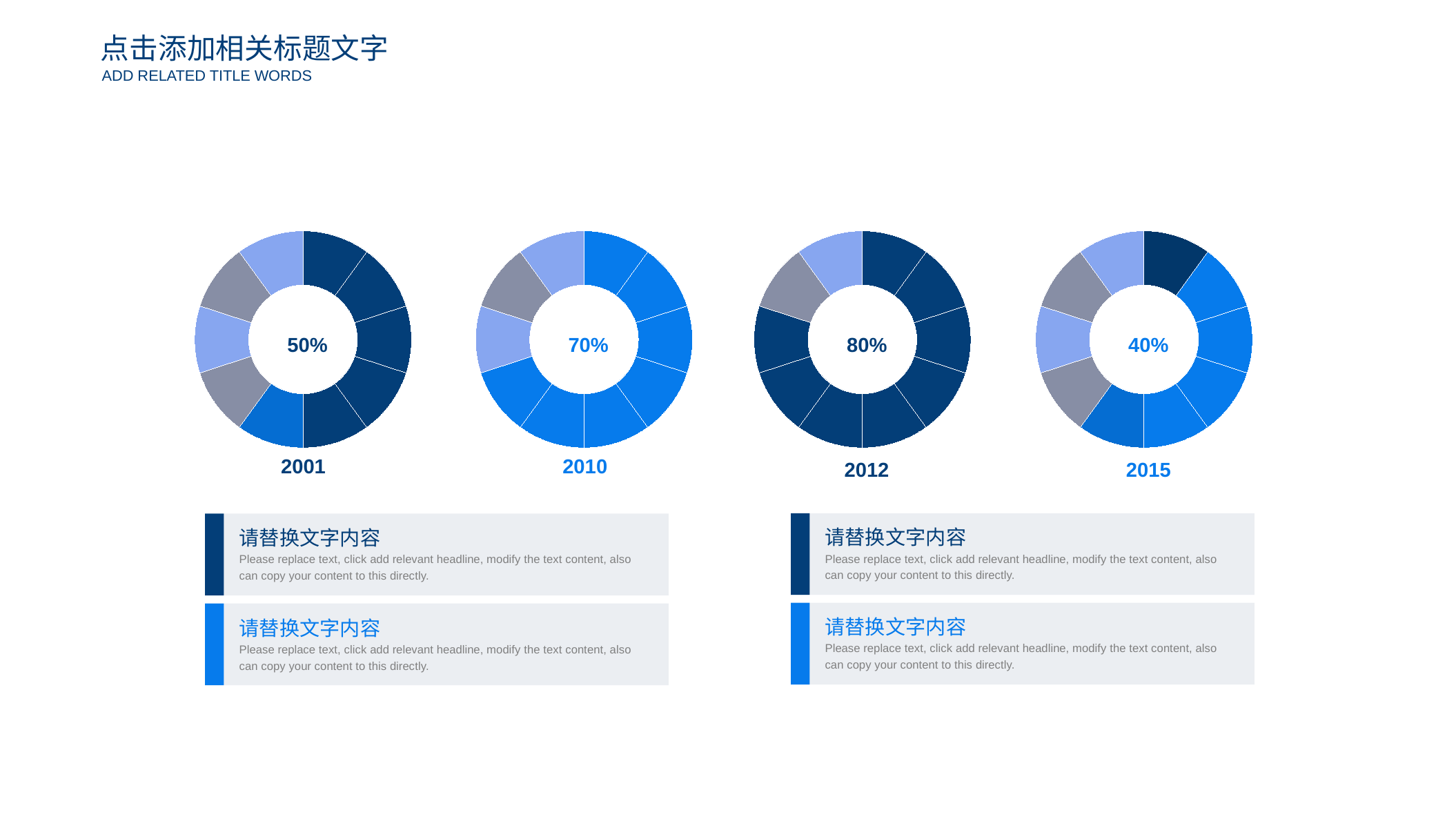
What percentage is shown in the centre of the donut chart labelled 2001? 50% Which shows a larger percentage, the 2010 donut chart or the 2015 donut chart? 2010 What kind of chart is used to display the percentages on this slide? Donut chart What percentage is shown in the centre of the donut chart labelled 2010? 70% What percentage is shown in the centre of the donut chart labelled 2012? 80% What year label appears under the third donut chart from the left? 2012 How many donut charts are shown on the slide? 4 What is the difference between the percentage shown for 2010 and the percentage shown for 2015? 30% Which year's donut chart shows the lowest percentage? 2015 What percentage is shown in the centre of the donut chart labelled 2015? 40% Which year's donut chart shows the highest percentage? 2012 What is the difference between the percentage shown for 2012 and the percentage shown for 2001? 30%